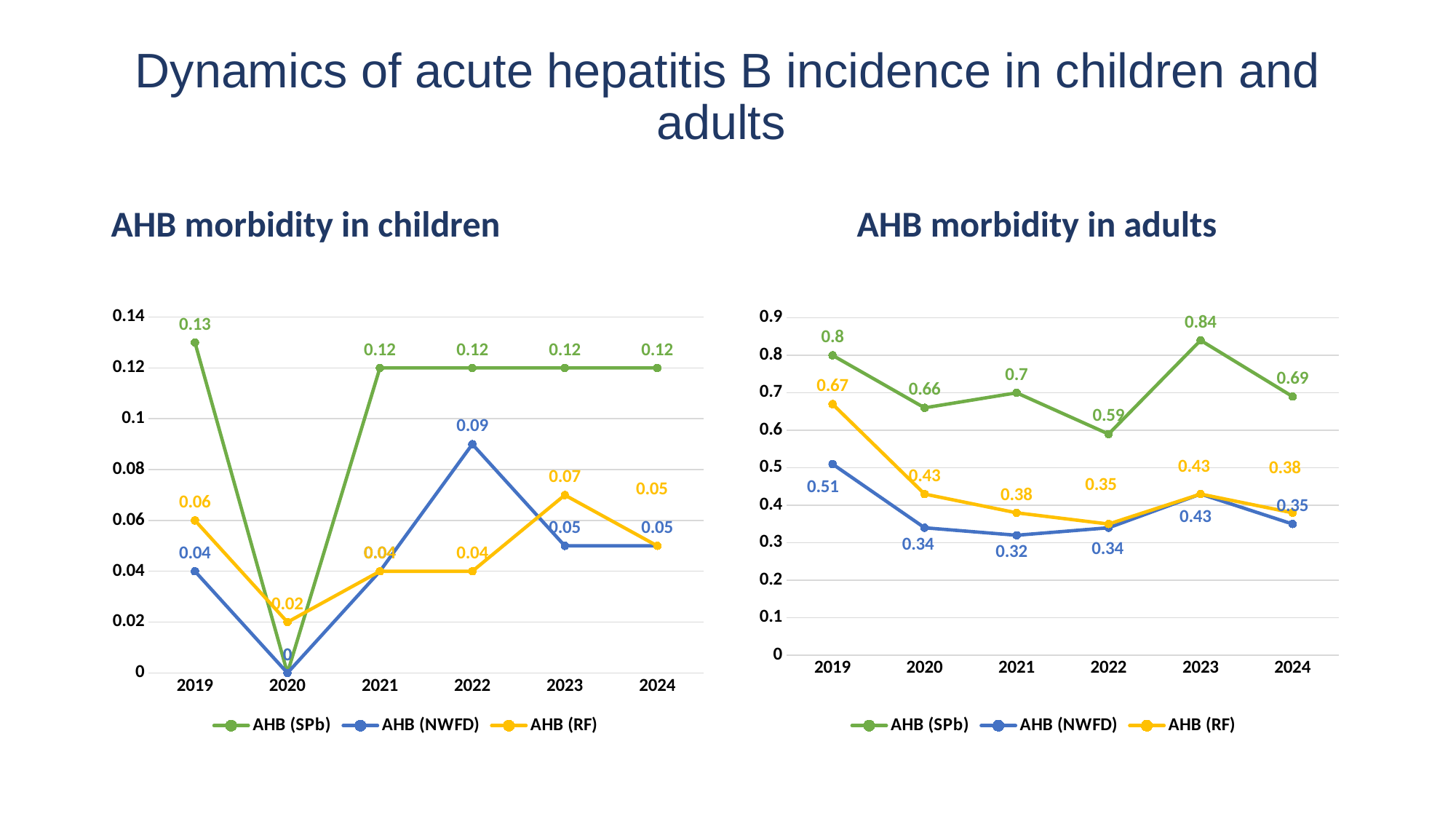
In the 'AHB morbidity in children' chart, which is larger in 2023: AHB (RF) or AHB (NWFD)? AHB (RF) In the 'AHB morbidity in adults' chart, in which year is the AHB (NWFD) value lowest? 2021 In the 'AHB morbidity in children' chart, what is the value for AHB (NWFD) in 2022? 0.09 In the 'AHB morbidity in adults' chart, by how much did AHB (RF) fall from 2019 to 2020? 0.24 In the 'AHB morbidity in adults' chart, in which year is the AHB (SPb) value highest? 2023 What kind of chart is 'AHB morbidity in children'? Line chart In the 'AHB morbidity in adults' chart, what is the difference between AHB (SPb) and AHB (NWFD) in 2019? 0.29 In the 'AHB morbidity in adults' chart, what is the value for AHB (SPb) in 2023? 0.84 In the 'AHB morbidity in adults' chart, is the value for AHB (SPb) in 2022 greater or less than 0.5? greater In the 'AHB morbidity in children' chart, what is the value for AHB (RF) in 2020? 0.02 How many series does the legend of the 'AHB morbidity in adults' chart list? 3 How many years are shown on the x axis of the 'AHB morbidity in children' chart? 6